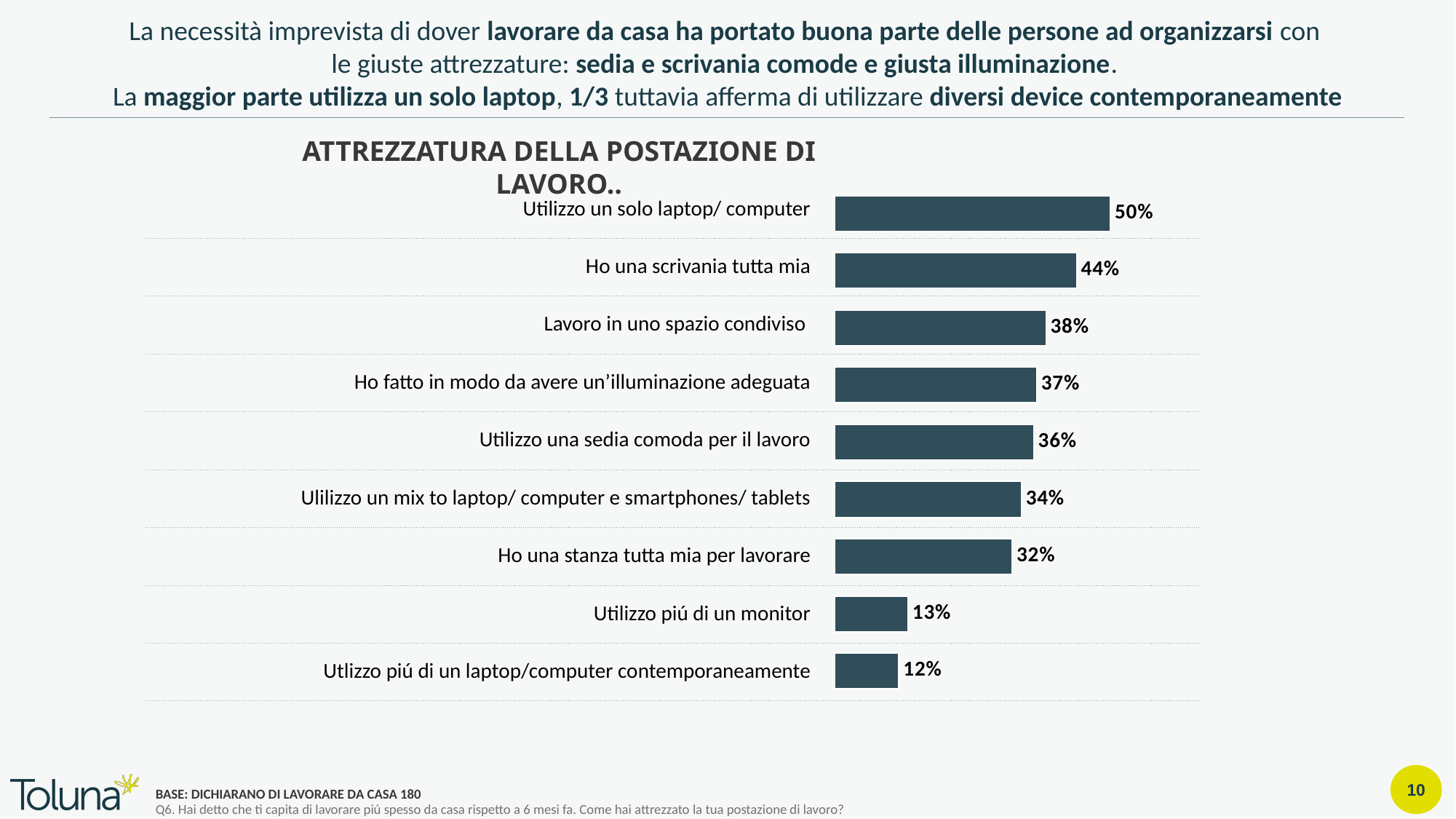
What is the difference between "Lavoro in uno spazio condiviso" and "Utilizzo piú di un monitor"? 25% What is the value for "Utilizzo un solo laptop/ computer"? 50% What is the value for "Utilizzo piú di un monitor"? 13% Which is larger: "Utilizzo una sedia comoda per il lavoro" or "Ulilizzo un mix to laptop/ computer e smartphones/ tablets"? Utilizzo una sedia comoda per il lavoro What kind of chart is shown on the slide? Bar chart What is the title of the chart? ATTREZZATURA DELLA POSTAZIONE DI LAVORO.. What is the value for "Ho una stanza tutta mia per lavorare"? 32% How many categories are shown in the chart? 9 What is the value for "Ho una scrivania tutta mia"? 44% Which category has the highest value? Utilizzo un solo laptop/ computer Which category has the lowest value? Utlizzo piú di un laptop/computer contemporaneamente What is the difference between "Utilizzo un solo laptop/ computer" and "Ho una scrivania tutta mia"? 6%